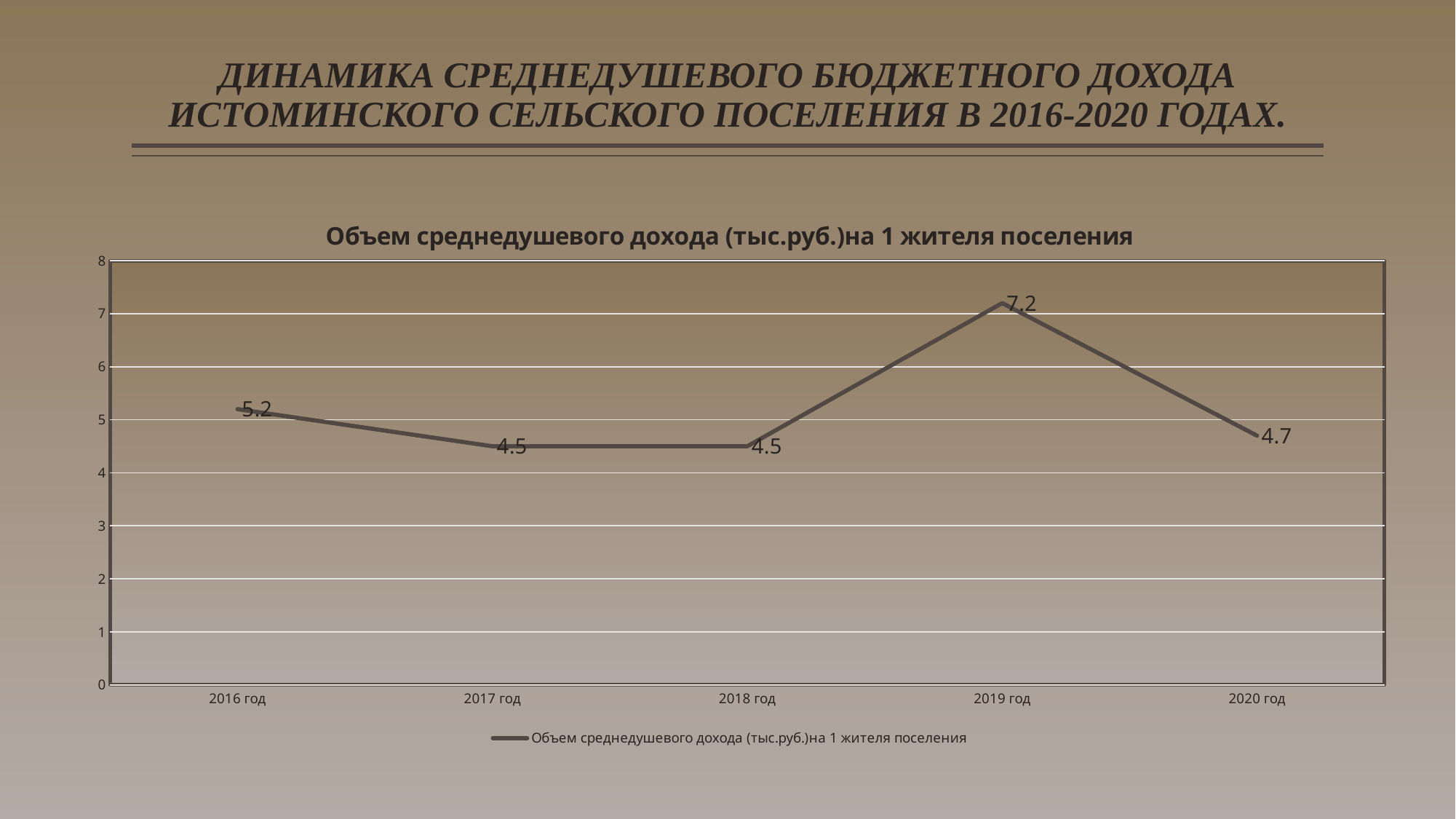
Is the value for 2019 год greater or less than 6? greater What kind of chart is shown? line chart What is the value for 2020 год? 4.7 What is the value for 2019 год? 7.2 What is the value for 2016 год? 5.2 What is the difference between the values for 2016 год and 2020 год? 0.5 How many series does the legend list? 1 Which year has the highest value? 2019 год Which is larger, the value for 2016 год or the value for 2020 год? 2016 год Does the value rise or fall from 2019 год to 2020 год? fall How many years are plotted on the chart? 5 What is the difference between the values for 2019 год and 2018 год? 2.7